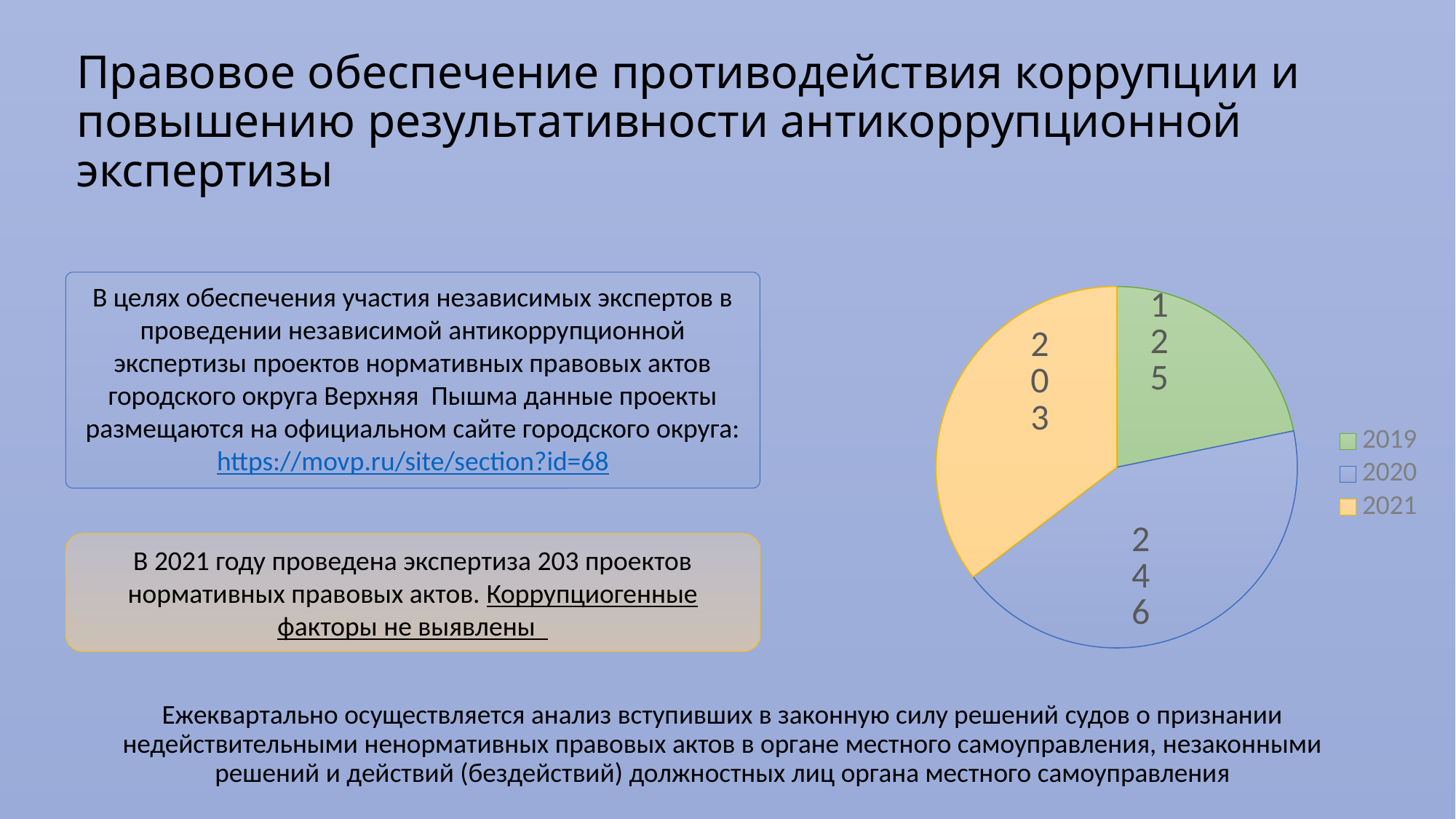
What value is shown for 2019 in the pie chart? 125 What is the difference between the values for 2020 and 2021 in the pie chart? 43 How many slices does the pie chart have? 3 Which is larger in the pie chart, the value for 2019 or the value for 2021? 2021 What value is shown for 2020 in the pie chart? 246 What is the difference between the values for 2021 and 2019 in the pie chart? 78 How many entries does the legend of the pie chart list? 3 Which year has the smallest slice in the pie chart? 2019 Which year has the largest slice in the pie chart? 2020 What colour is the slice for 2021 in the pie chart? Yellow What value is shown for 2021 in the pie chart? 203 What kind of chart is shown on the slide? Pie chart